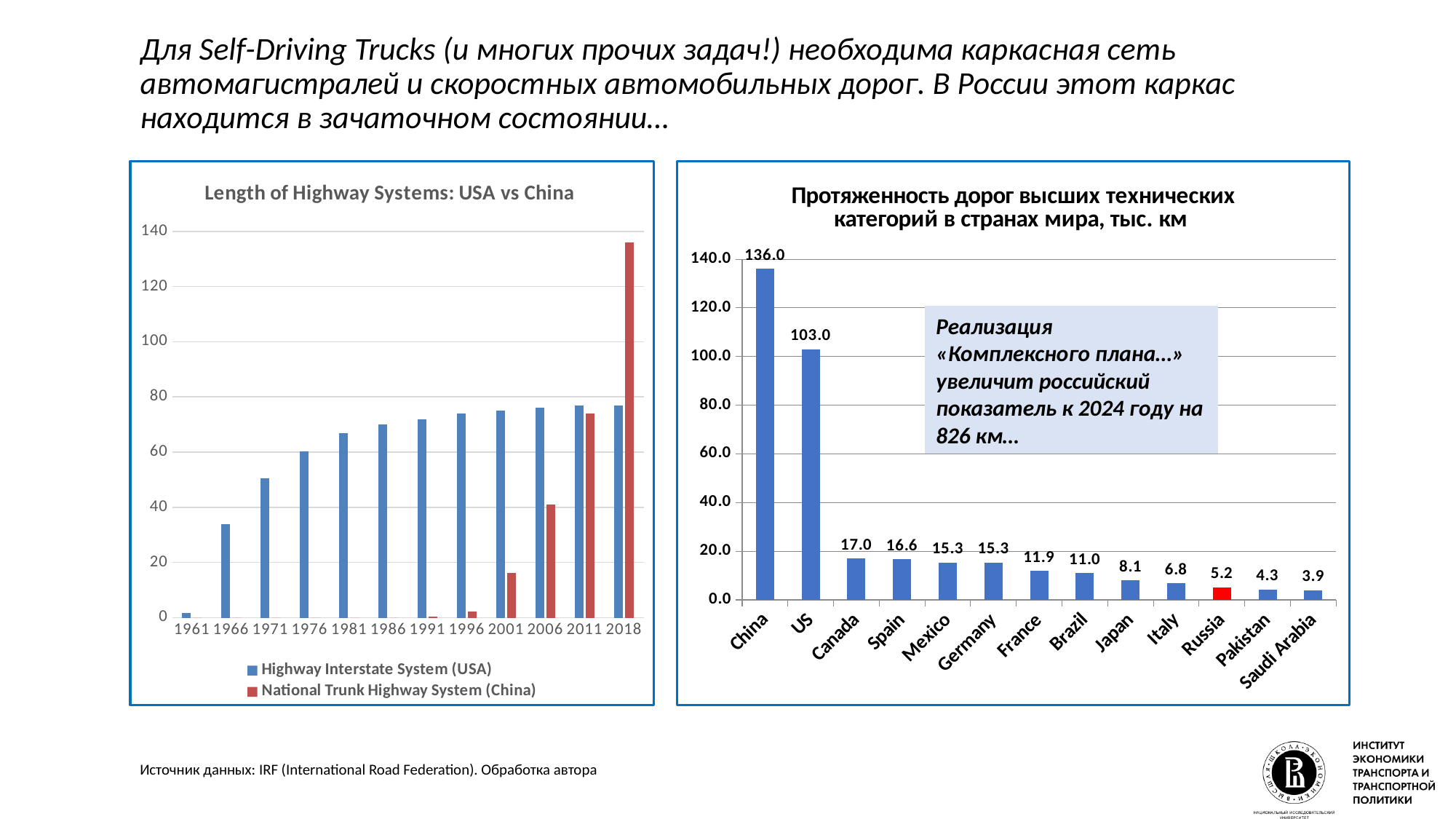
In the right chart (Протяженность дорог высших технических категорий), which country has the highest value? China In the right chart (Протяженность дорог высших технических категорий), which is larger, the value for Canada or the value for Japan? Canada In the right chart (Протяженность дорог высших технических категорий), what is the value for Russia? 5.2 What kind of chart is the left chart (Length of Highway Systems: USA vs China)? bar chart In the left chart (Length of Highway Systems: USA vs China), is the value for Highway Interstate System (USA) in 1961 greater or less than 20? less In the right chart (Протяженность дорог высших технических категорий), how many countries are shown? 13 In the right chart (Протяженность дорог высших технических категорий), what is the value for US? 103.0 In the left chart (Length of Highway Systems: USA vs China), is the value for National Trunk Highway System (China) in 2018 greater or less than 120? greater In the right chart (Протяженность дорог высших технических категорий), which country has the lowest value? Saudi Arabia In the left chart (Length of Highway Systems: USA vs China), does the Highway Interstate System (USA) series generally rise or fall from 1961 to 2018? rise In the right chart (Протяженность дорог высших технических категорий), what is the difference between the values for China and US? 33.0 In the left chart (Length of Highway Systems: USA vs China), how many series does the legend list? 2